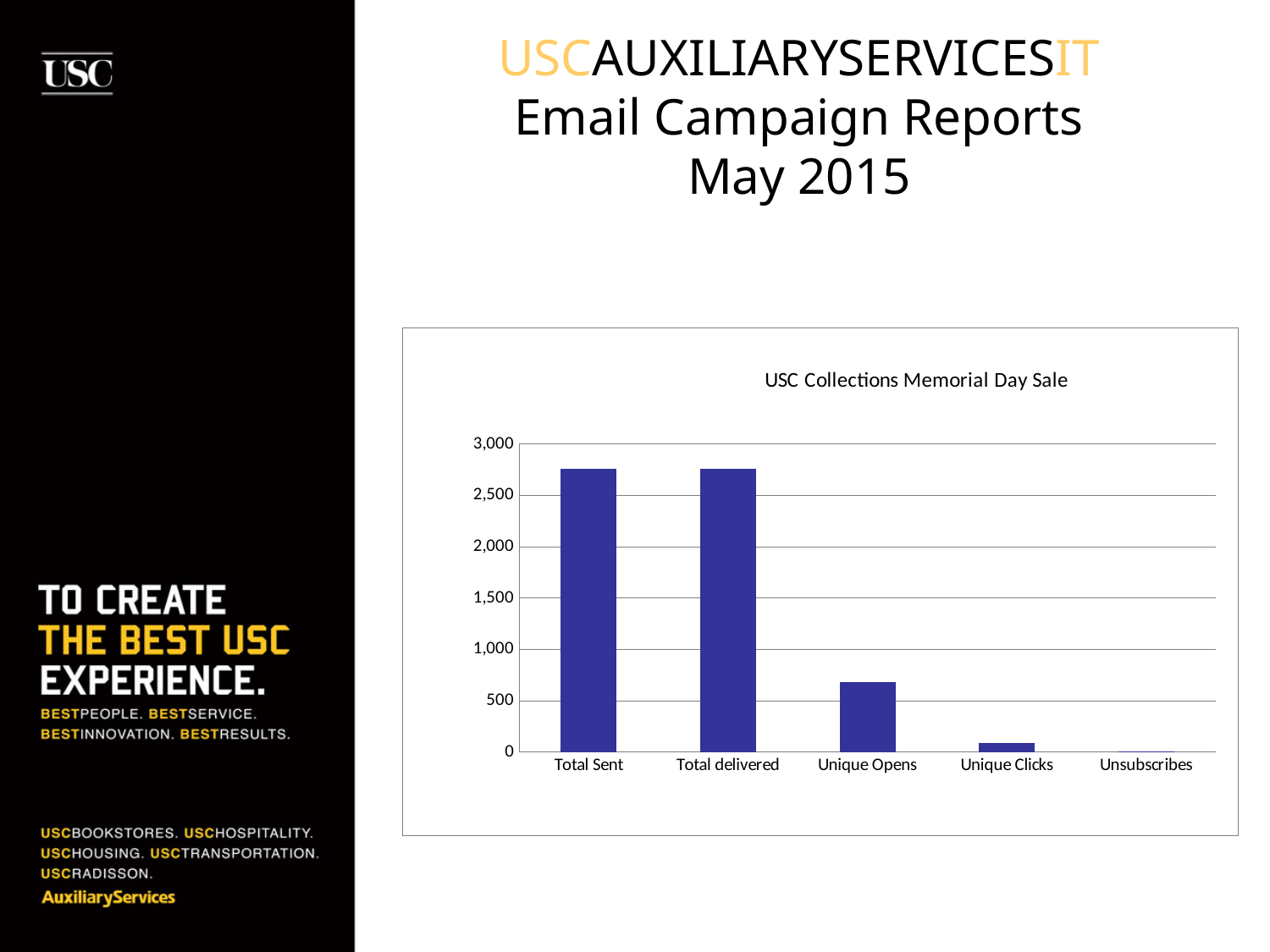
Is the value for Unique Opens greater or less than 500? greater Is the value for Unique Opens greater or less than 1,000? less What kind of chart is shown on the slide? bar chart Is the value for Total Sent greater or less than 2,500? greater Which category has the lowest value in the chart? Unsubscribes Which is larger, the value for Total Sent or the value for Unique Opens? Total Sent What is the title of the chart? USC Collections Memorial Day Sale Do the values generally rise or fall moving from left to right along the x axis? fall How many categories are shown on the x axis of the chart? 5 Which is larger, the value for Unique Opens or the value for Unique Clicks? Unique Opens